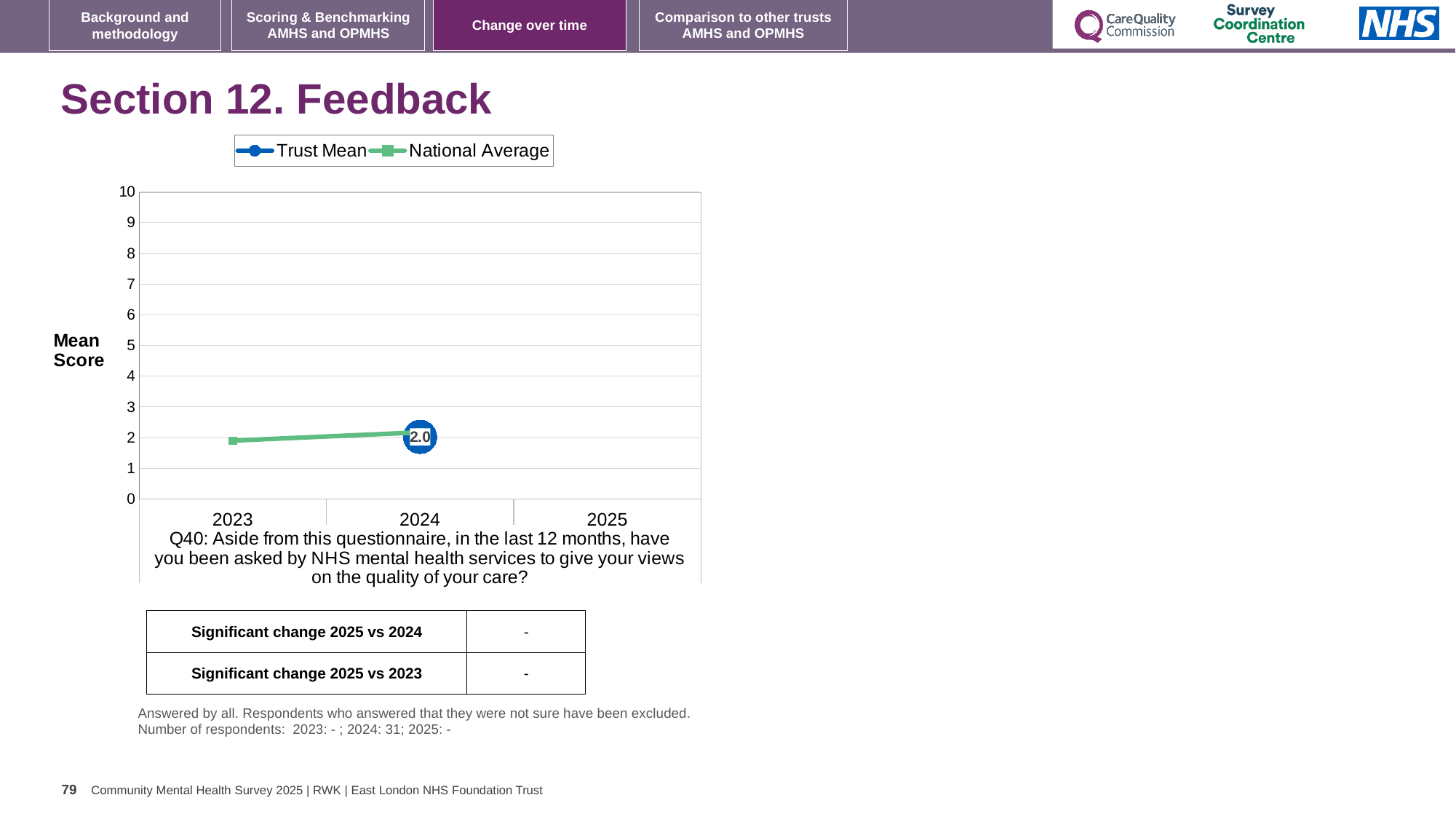
Is the National Average value for 2023 greater or less than 5? less How many years are shown on the x axis? 3 What is the Trust Mean value for 2024? 2.0 Which series is shown in green? National Average What is the highest value shown on the y axis? 10 Is the Trust Mean value for 2024 greater or less than 1? greater What is the label on the y axis? Mean Score What kind of chart is shown on the slide? line chart Does the National Average line rise or fall from 2023 to 2024? rise How many series does the legend list? 2